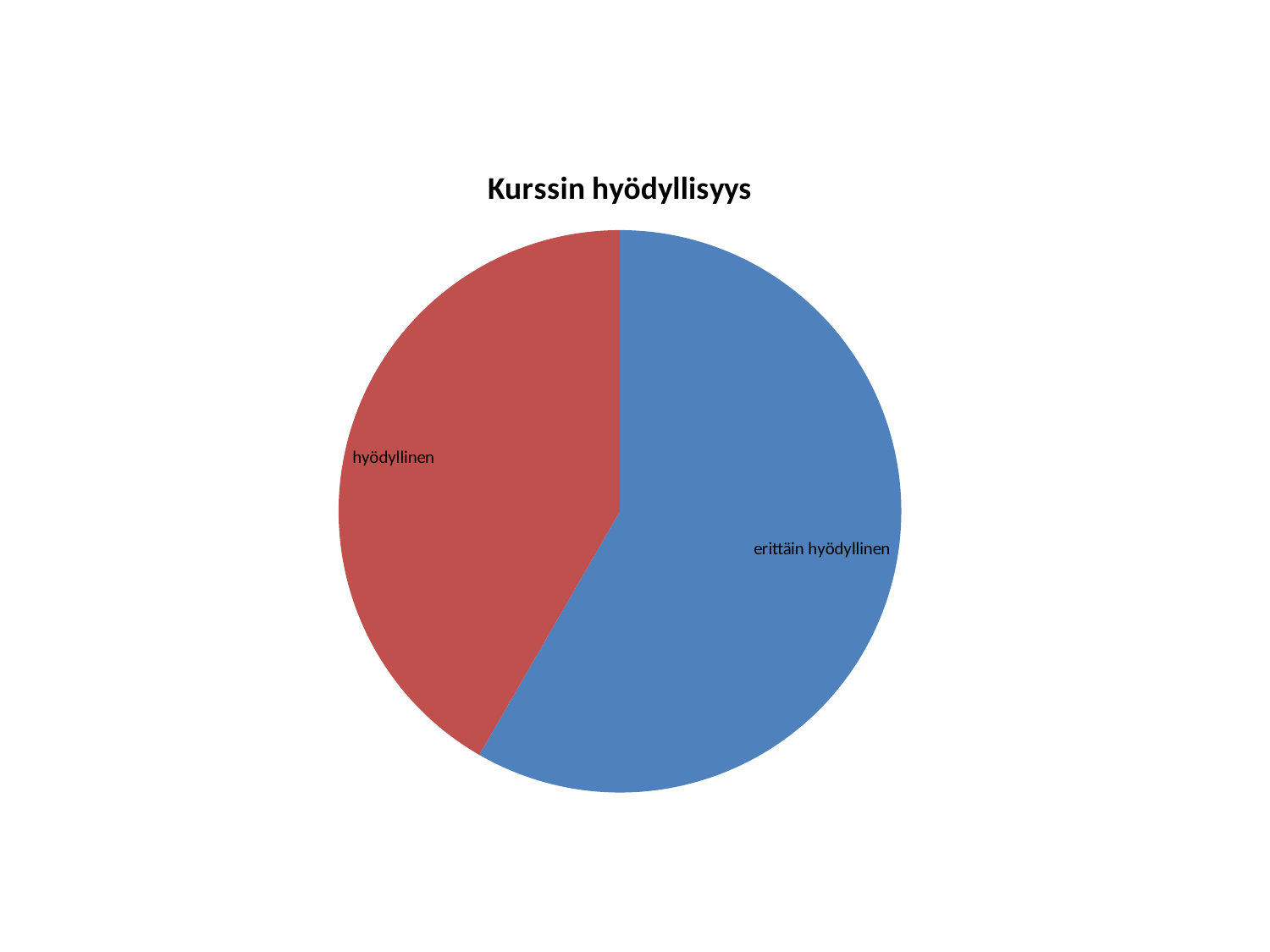
Which slice of the pie is the largest? erittäin hyödyllinen What is the title of the chart? Kurssin hyödyllisyys What kind of chart is shown on the slide? pie chart Which slice of the pie is the smallest? hyödyllinen How many slices does the pie chart have? 2 What colour is the "erittäin hyödyllinen" slice? blue Which slice is larger, "hyödyllinen" or "erittäin hyödyllinen"? erittäin hyödyllinen